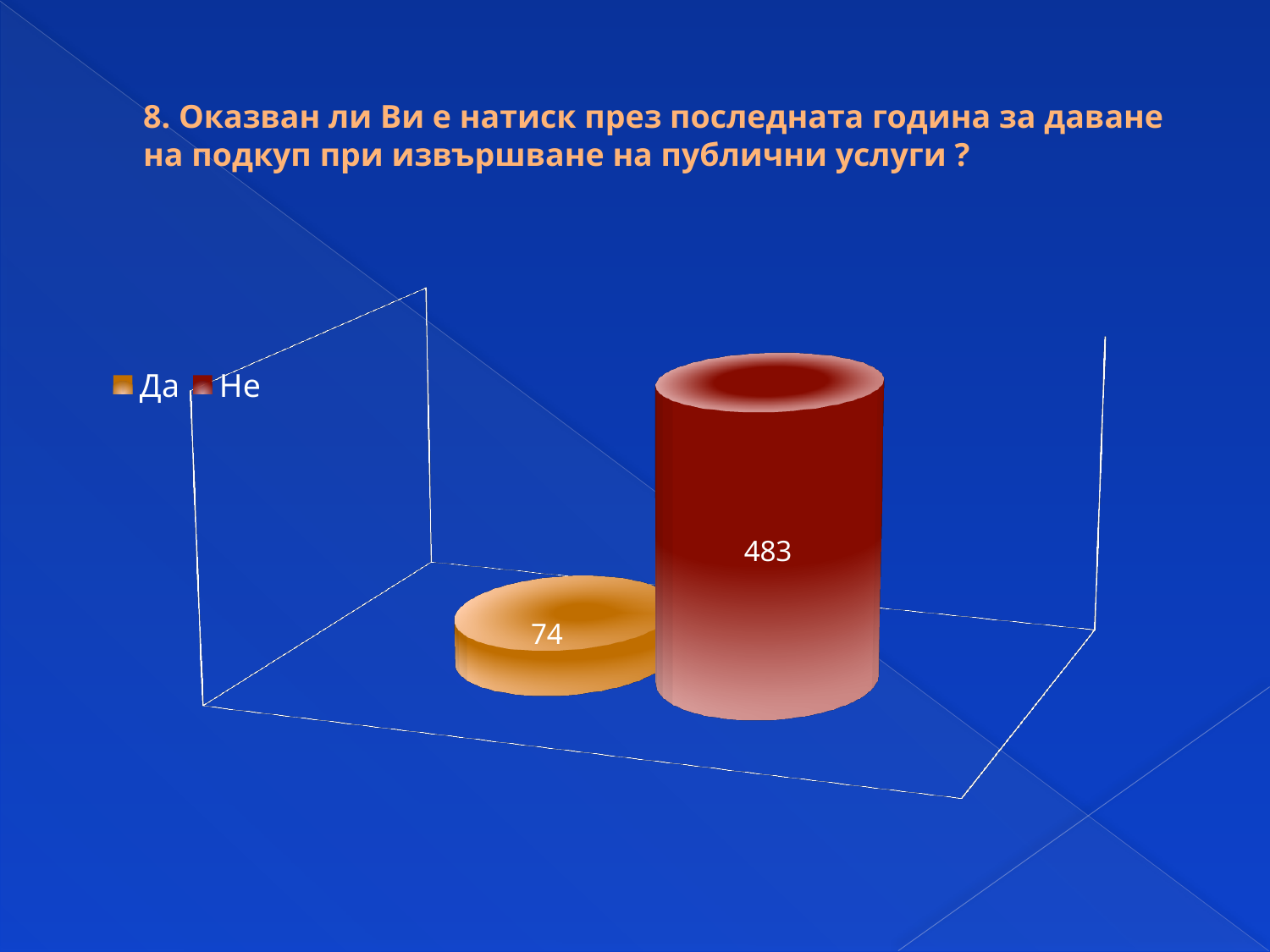
What is the value for "Не"? 483 How many series does the legend list? 2 What colour is the bar for "Да"? Orange Which category has the lowest value? Да What kind of chart is shown on the slide? Bar chart Which category has the highest value? Не What is the difference between the values for "Не" and "Да"? 409 How many bars are plotted in the chart? 2 What colour is the bar for "Не"? Red Which is larger, the value for "Да" or the value for "Не"? Не What is the value for "Да"? 74 What is the total of the two values shown in the chart? 557